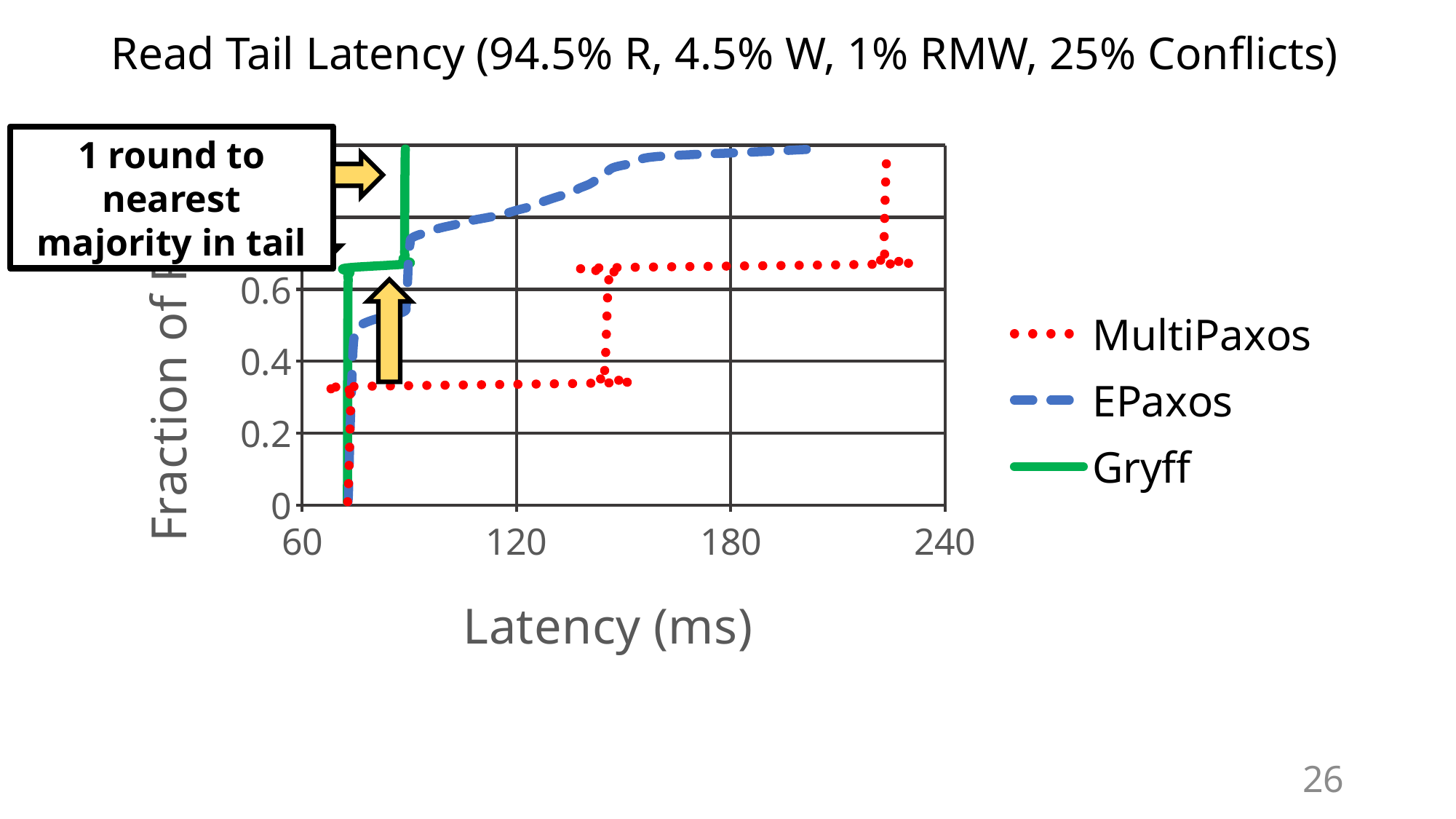
Is the fraction at which the MultiPaxos line plateaus for the second time greater or less than 0.6? greater Is the latency at which the MultiPaxos line finally rises to the top of the plot greater or less than 180? greater Is the latency at which the MultiPaxos line makes its second jump greater or less than 120? greater How many series does the legend list? 3 What kind of chart is shown on the slide? line chart Do the plotted lines rise or fall as latency increases along the x axis? rise What is the title of the chart? Read Tail Latency (94.5% R, 4.5% W, 1% RMW, 25% Conflicts) Which series is drawn as a solid green line? Gryff Which series reaches the top of the plot at the lowest latency? Gryff What is the label of the x axis? Latency (ms)